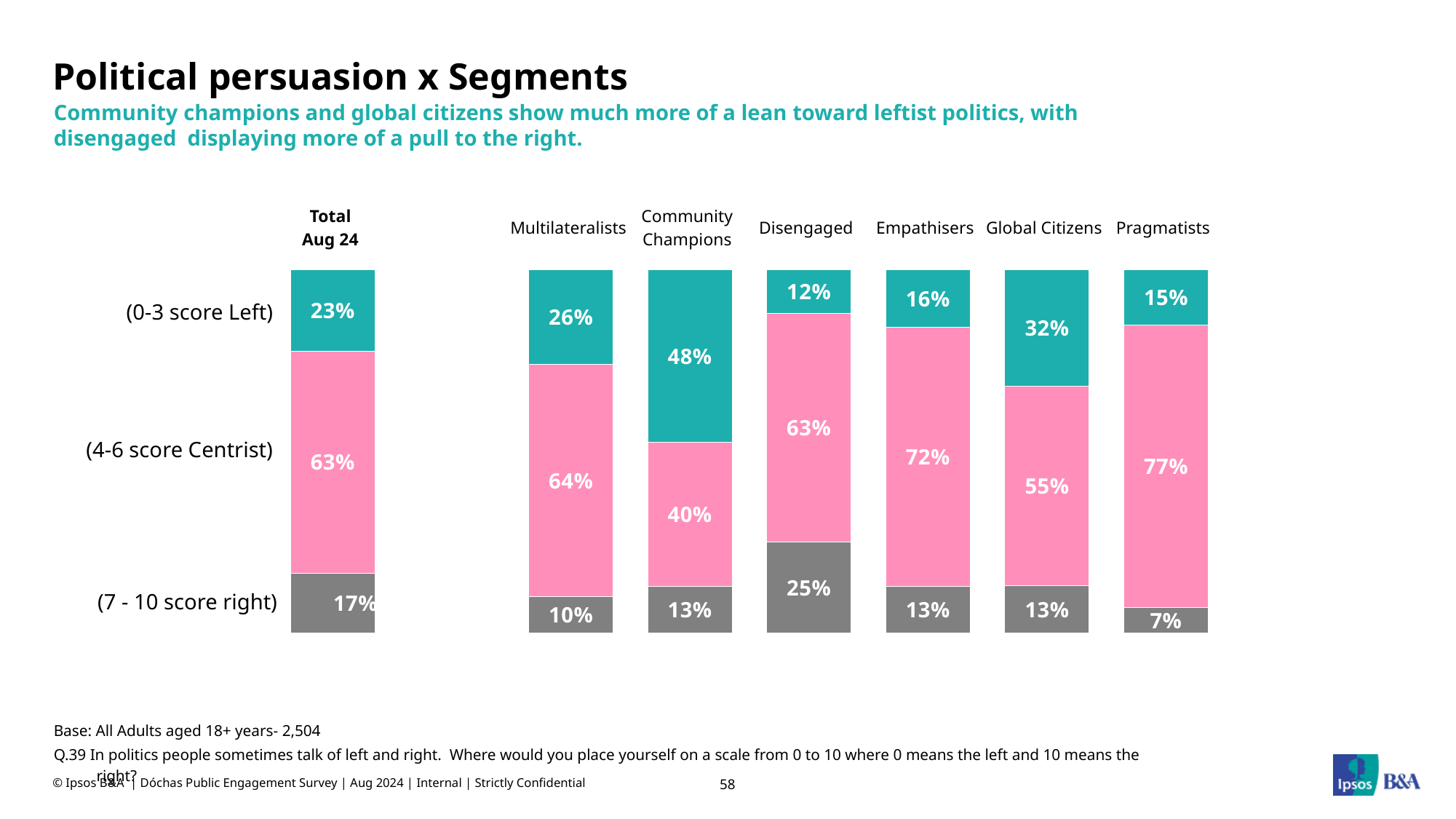
What percentage of Disengaged score right (7-10)? 25% How many score bands (series) are stacked in each bar? 3 Which segment has the lowest share scoring right (7-10)? Pragmatists What percentage of the Total (Aug 24) score Centrist (4-6)? 63% Which is larger: the right (7-10) share for Multilateralists or for Disengaged? Disengaged What is the difference between the Left (0-3) share for Global Citizens and for Empathisers? 16 percentage points What type of chart is shown on the slide? Stacked bar chart Which segment has the highest share scoring Left (0-3)? Community Champions What percentage of Community Champions score Left (0-3)? 48% How many bars are shown in the chart, including the Total bar? 7 Which segment has the highest share scoring Centrist (4-6)? Pragmatists Which colour represents the (7 - 10 score right) band? Grey